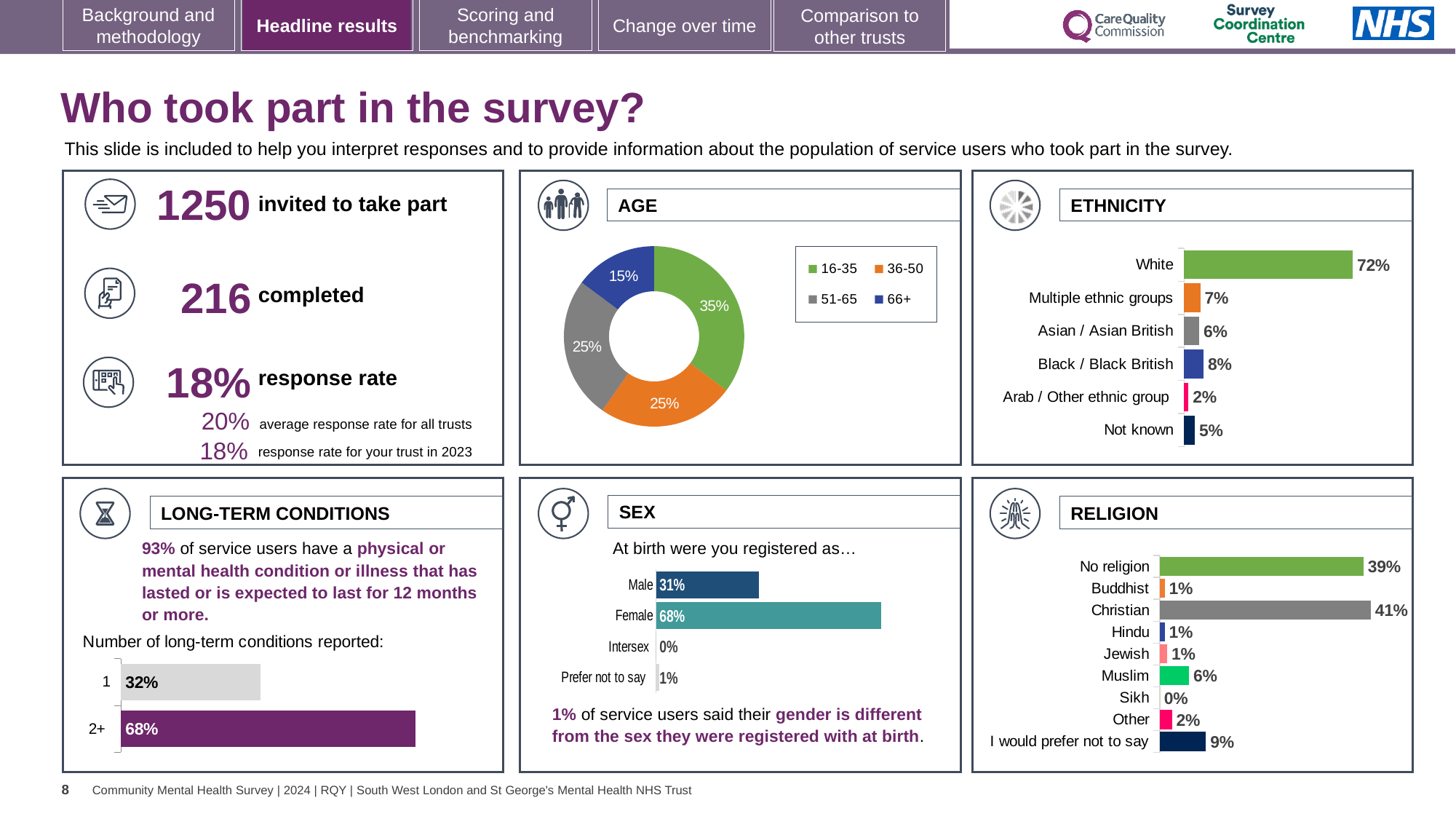
In the ETHNICITY chart, what is the difference between White and Multiple ethnic groups? 65% In the SEX chart, which is larger, Male or Female? Female In the AGE chart, what kind of chart is used? Donut (pie) chart In the ETHNICITY chart, how many categories are shown? 6 In the AGE chart, what share of respondents are aged 16-35? 35% In the ETHNICITY chart, what is the value for Black / Black British? 8% In the RELIGION chart, what is the value for I would prefer not to say? 9% In the SEX chart, what is the value for Prefer not to say? 1% In the AGE chart, how many age groups does the legend list? 4 In the ETHNICITY chart, which category has the highest value? White In the LONG-TERM CONDITIONS chart, what percentage of service users reported 2+ long-term conditions? 68% In the RELIGION chart, which category has the highest value? Christian